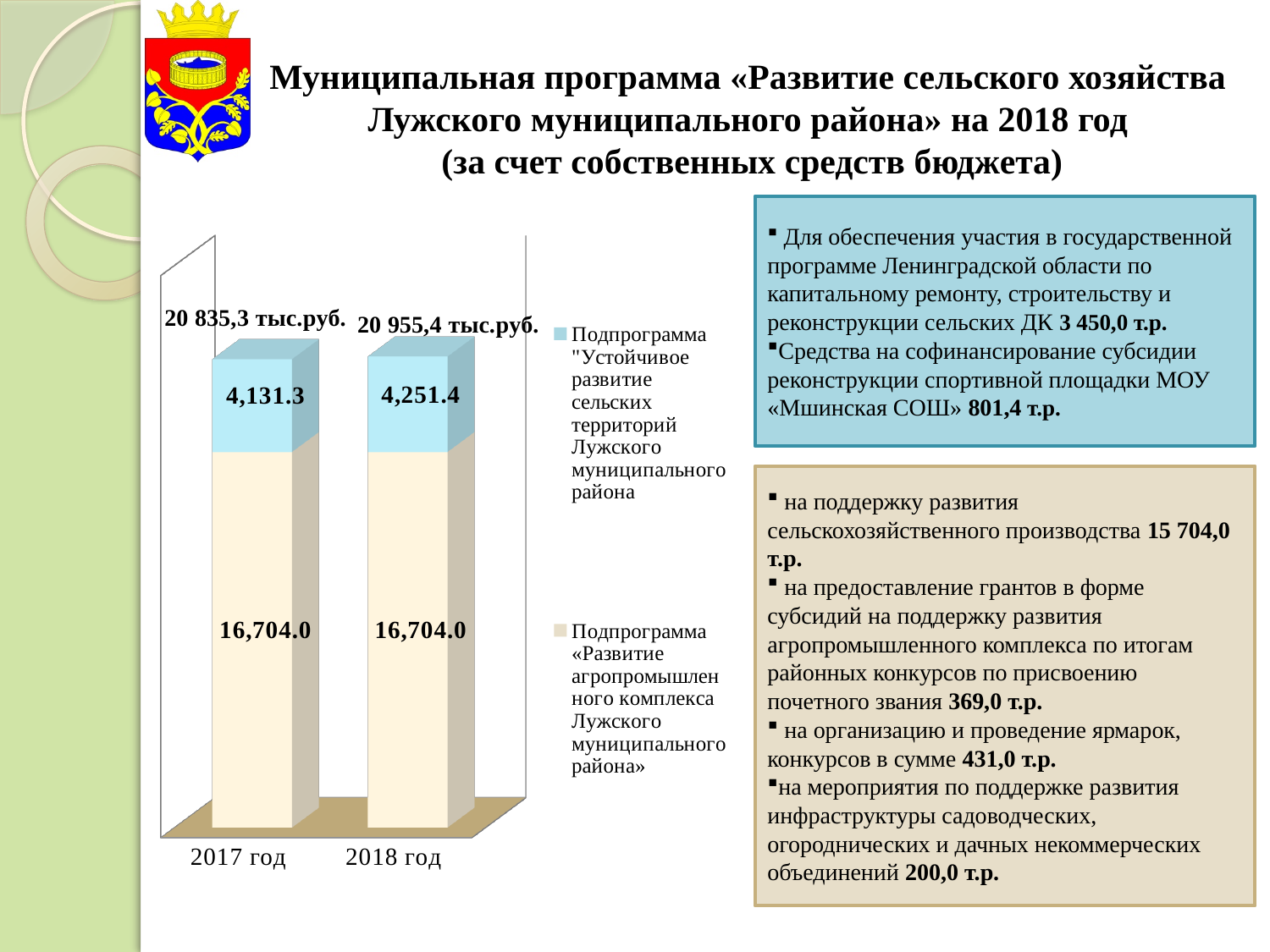
What is the value of the "Развитие агропромышленного комплекса" subprogram for 2017 год? 16,704.0 How many categories (years) are shown on the x axis of the chart? 2 How many series does the chart legend list? 2 Within the 2018 год bar, which subprogram has the larger value? Подпрограмма «Развитие агропромышленного комплекса Лужского муниципального района» What is the value of the "Развитие агропромышленного комплекса" subprogram for 2018 год? 16,704.0 What kind of chart is shown on the slide? Stacked bar chart What is the total shown above the stacked bar for 2018 год? 20 955,4 тыс.руб. What is the total shown above the stacked bar for 2017 год? 20 835,3 тыс.руб. What is the value of the "Устойчивое развитие сельских территорий" subprogram for 2017 год? 4,131.3 Which year has the larger value for the "Устойчивое развитие сельских территорий" subprogram, 2017 год or 2018 год? 2018 год What is the value of the "Устойчивое развитие сельских территорий" subprogram for 2018 год? 4,251.4 What is the difference between the "Устойчивое развитие сельских территорий" values for 2018 год and 2017 год? 120.1